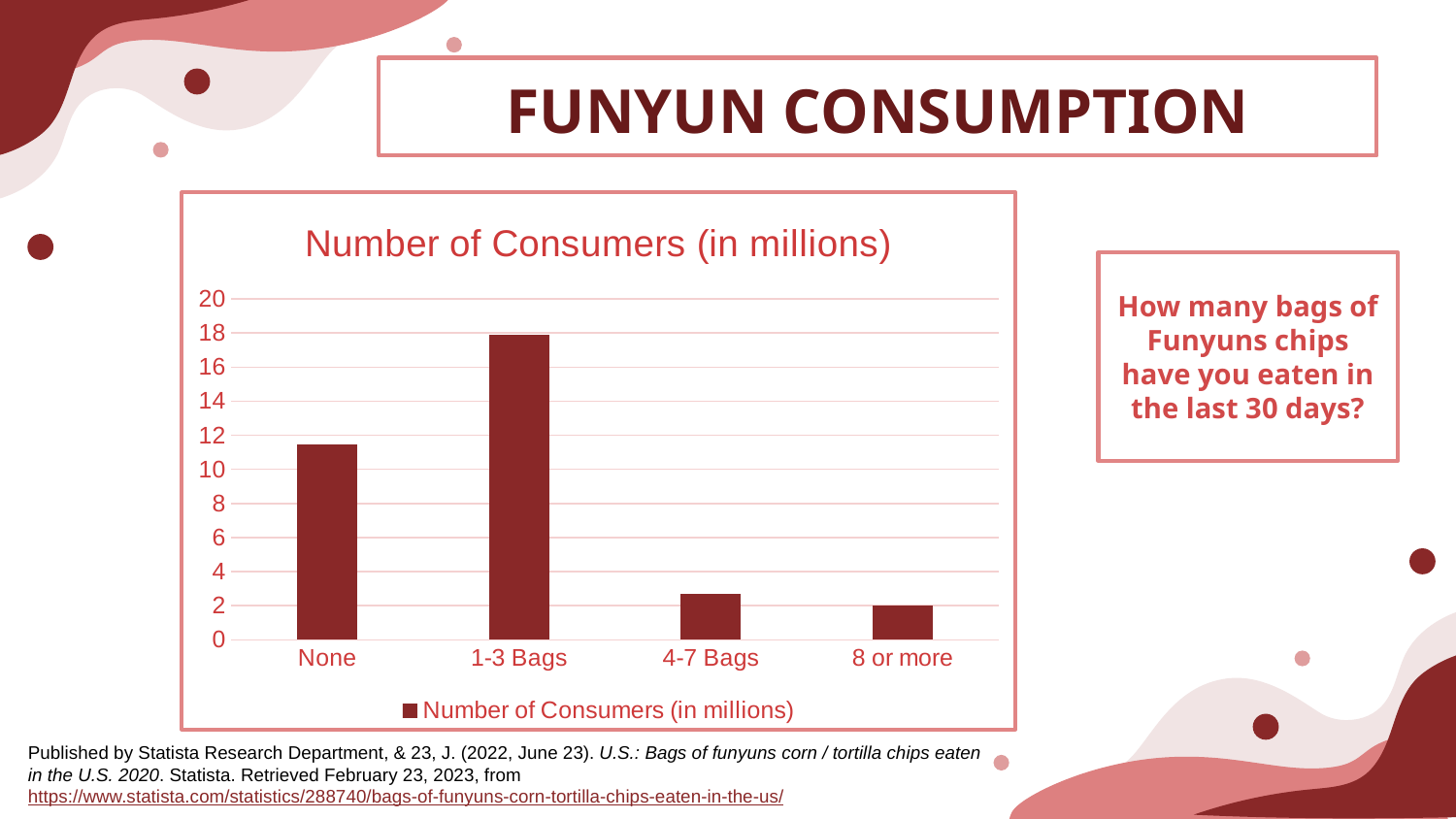
What is the title of the chart? Number of Consumers (in millions) What kind of chart is shown on the slide? bar chart What is the legend entry shown below the chart? Number of Consumers (in millions) Which category has the lowest number of consumers? 8 or more Is the value for None greater or less than 10? greater Which is larger, the value for 4-7 Bags or the value for None? None Is the value for 4-7 Bags greater or less than 4? less How many series does the chart's legend list? 1 Which is larger, the value for None or the value for 1-3 Bags? 1-3 Bags Is the value for 1-3 Bags greater or less than 16? greater Which category has the highest number of consumers? 1-3 Bags How many categories are shown on the x axis of the chart? 4